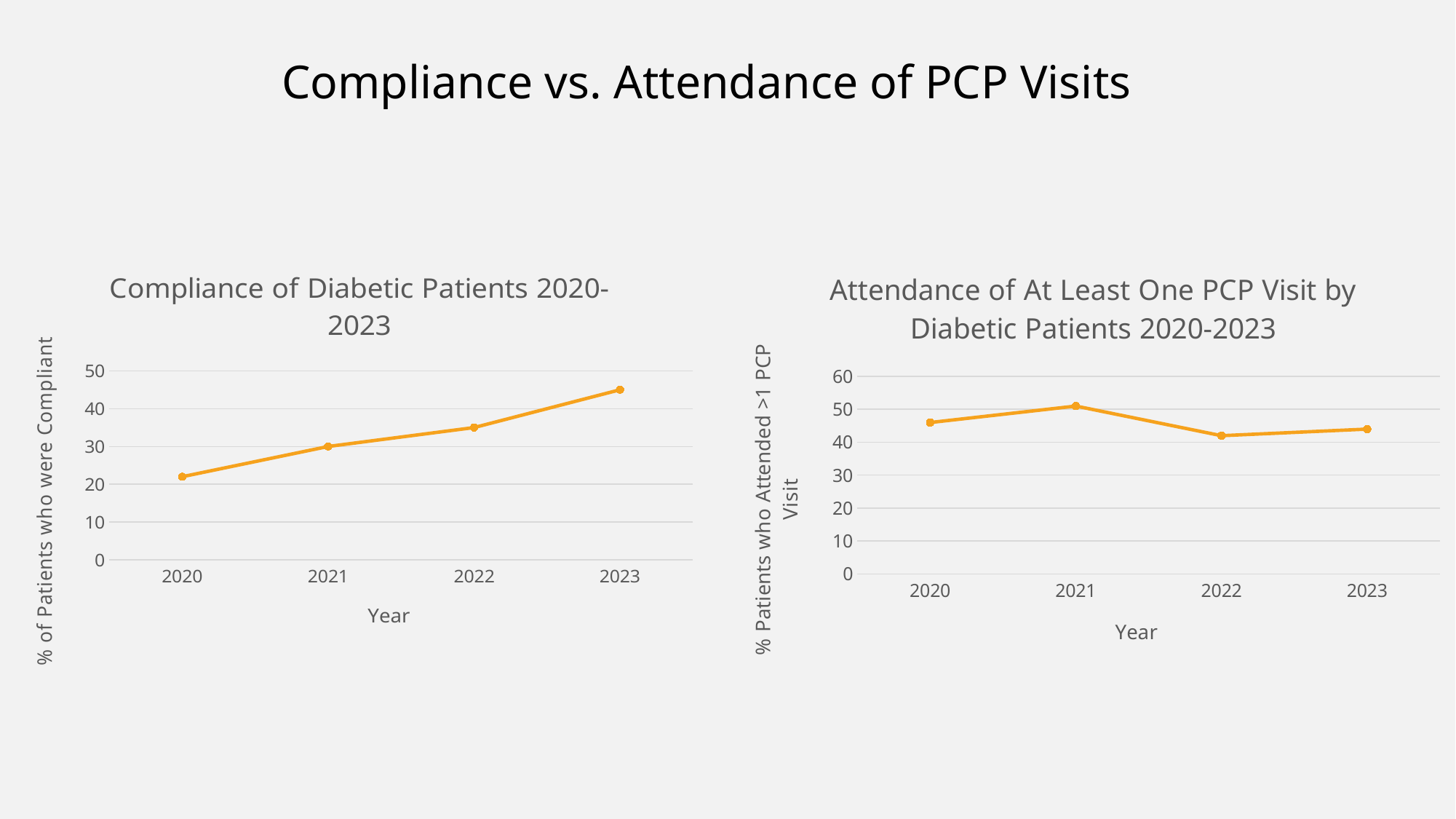
How many years are plotted in the 'Compliance of Diabetic Patients 2020-2023' chart? 4 In the 'Compliance of Diabetic Patients 2020-2023' chart, which year has the highest value? 2023 In the 'Attendance of At Least One PCP Visit by Diabetic Patients 2020-2023' chart, which year has the lowest value? 2022 What type of chart is the 'Compliance of Diabetic Patients 2020-2023' chart? line chart In the 'Attendance of At Least One PCP Visit by Diabetic Patients 2020-2023' chart, is the value for 2022 greater or less than 50? less In the 'Attendance of At Least One PCP Visit by Diabetic Patients 2020-2023' chart, which year has the highest value? 2021 In the 'Compliance of Diabetic Patients 2020-2023' chart, which year has the lowest value? 2020 In the 'Compliance of Diabetic Patients 2020-2023' chart, is the value for 2023 greater or less than 40? greater What is the x-axis label of the 'Attendance of At Least One PCP Visit by Diabetic Patients 2020-2023' chart? Year In the 'Compliance of Diabetic Patients 2020-2023' chart, is the value for 2020 greater or less than 30? less In the 'Compliance of Diabetic Patients 2020-2023' chart, do the values rise or fall from 2020 to 2023? rise